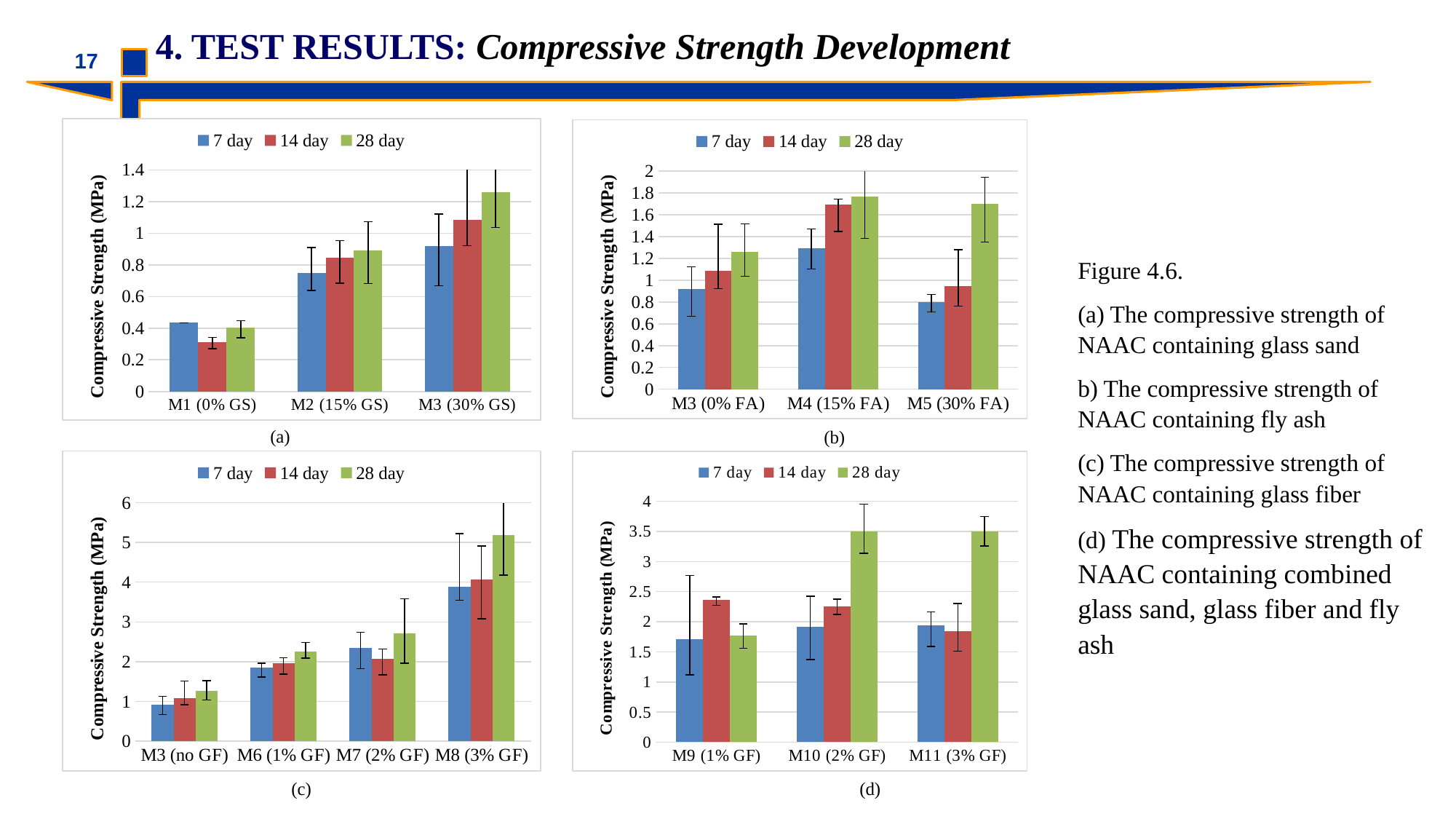
In chart (c), do the 28 day values rise or fall from M3 (no GF) to M8 (3% GF)? rise In chart (b), is the 28 day value for M4 (15% FA) greater or less than 1.6? greater In chart (a), which mix has the highest 28 day compressive strength? M3 (30% GS) In chart (a), how many mix categories are shown on the x axis? 3 In chart (b), which mix has the highest 14 day compressive strength? M4 (15% FA) In chart (c), how many mix categories are shown on the x axis? 4 In chart (a), is the 7 day value for M1 (0% GS) greater or less than 0.6? less In chart (a), what kind of chart is shown? bar chart In chart (c), is the 28 day value for M8 (3% GF) greater or less than 4? greater In chart (d), which mix has the lowest 14 day compressive strength? M11 (3% GF) In chart (a), how many series does the legend list? 3 In chart (d), for M10 (2% GF), which is larger: the 14 day value or the 28 day value? 28 day